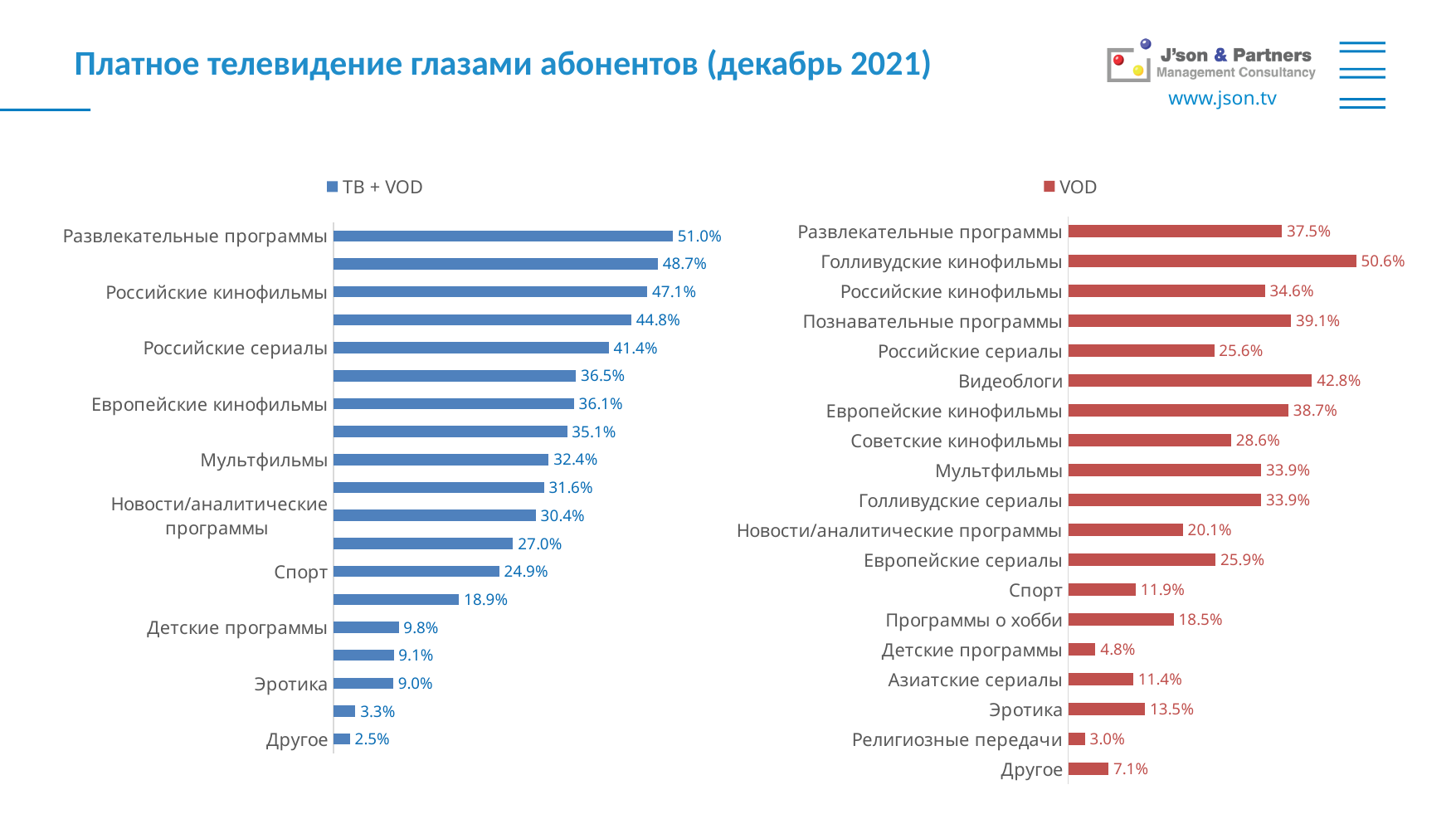
How many categories are shown in the VOD chart on the right? 19 Which is larger: Эротика in the ТВ + VOD chart or Эротика in the VOD chart? VOD chart In the VOD chart on the right, which category has the lowest value? Религиозные передачи What type of chart is the VOD chart on the right? Bar chart In the VOD chart on the right, what is the value for Голливудские кинофильмы? 50.6% In the ТВ + VOD chart on the left, what is the value for Российские сериалы? 41.4% In the ТВ + VOD chart on the left, what is the difference between Развлекательные программы and Другое? 48.5% In the VOD chart on the right, which is larger: Познавательные программы or Европейские кинофильмы? Познавательные программы In the VOD chart on the right, what is the difference between Видеоблоги and Спорт? 30.9% In the VOD chart on the right, which category has the highest value? Голливудские кинофильмы What is the legend entry of the chart on the left? ТВ + VOD In the ТВ + VOD chart on the left, which category has the highest value? Развлекательные программы